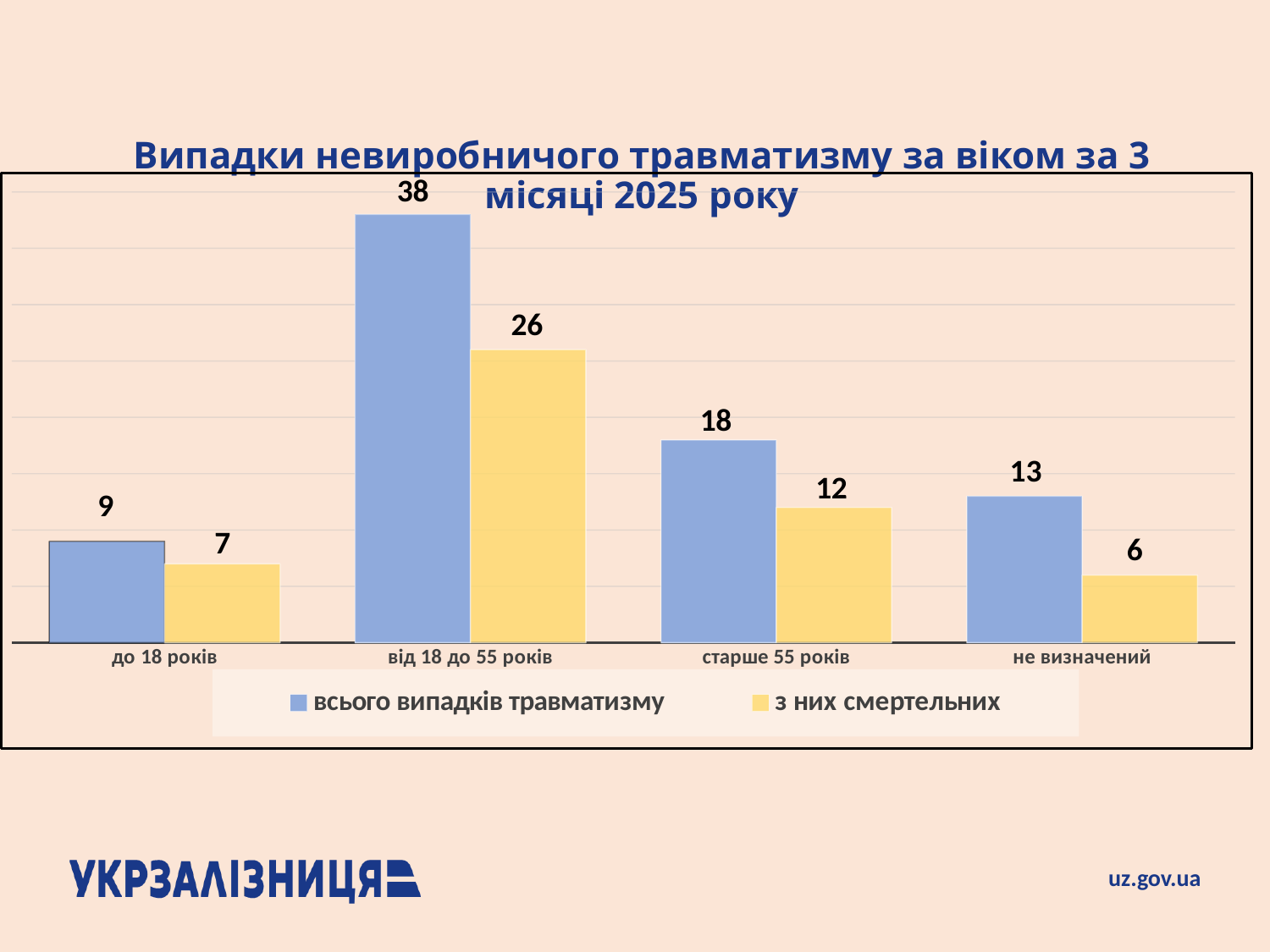
Which age category has the lowest value for 'з них смертельних'? не визначений What colour are the bars for 'з них смертельних'? yellow What is the value of 'з них смертельних' for 'старше 55 років'? 12 Which age category has the highest value for 'всього випадків травматизму'? від 18 до 55 років What is the value of 'з них смертельних' for 'не визначений'? 6 How many series does the legend list? 2 What is the value of 'всього випадків травматизму' for 'від 18 до 55 років'? 38 What is the difference between 'всього випадків травматизму' and 'з них смертельних' for 'від 18 до 55 років'? 12 What is the difference between 'всього випадків травматизму' for 'старше 55 років' and for 'до 18 років'? 9 What kind of chart is shown on the slide? bar chart Which is larger: 'з них смертельних' for 'до 18 років' or for 'не визначений'? до 18 років How many age categories are shown on the x axis? 4